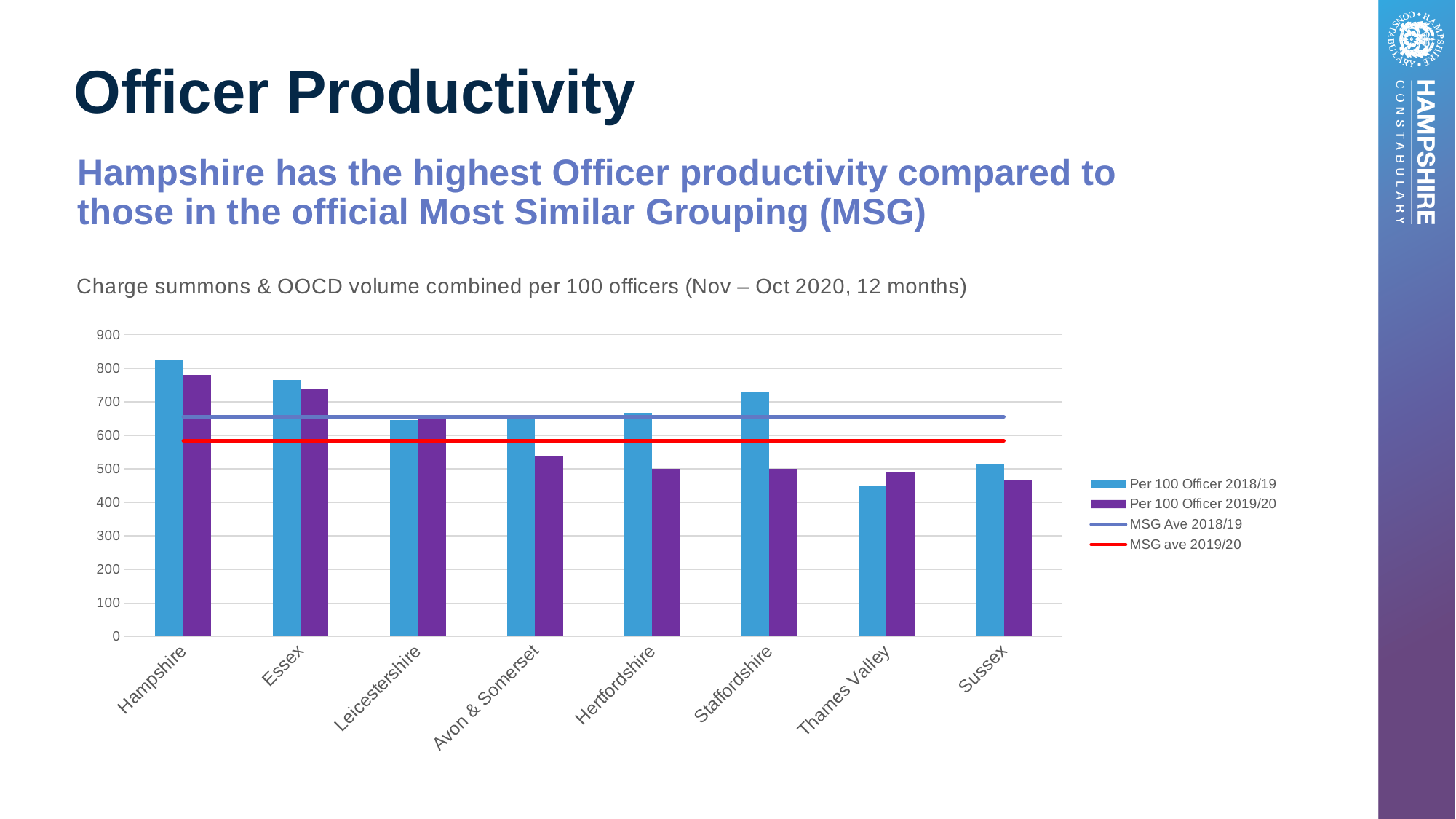
How many series does the chart's legend list? 4 What kind of chart is shown on the slide? combination bar and line chart Is the Per 100 Officer 2018/19 value for Hampshire greater or less than 800? greater Is the Per 100 Officer 2018/19 value for Thames Valley greater or less than 500? less Is the Per 100 Officer 2019/20 value for Avon & Somerset greater or less than 500? greater Which force has the highest value for Per 100 Officer 2019/20? Hampshire Which line in the legend is drawn in red? MSG ave 2019/20 Which force has the lowest value for Per 100 Officer 2018/19? Thames Valley How many police forces are shown on the x axis of the chart? 8 Which force has the highest value for Per 100 Officer 2018/19? Hampshire For Thames Valley, which is larger: the Per 100 Officer 2018/19 value or the Per 100 Officer 2019/20 value? Per 100 Officer 2019/20